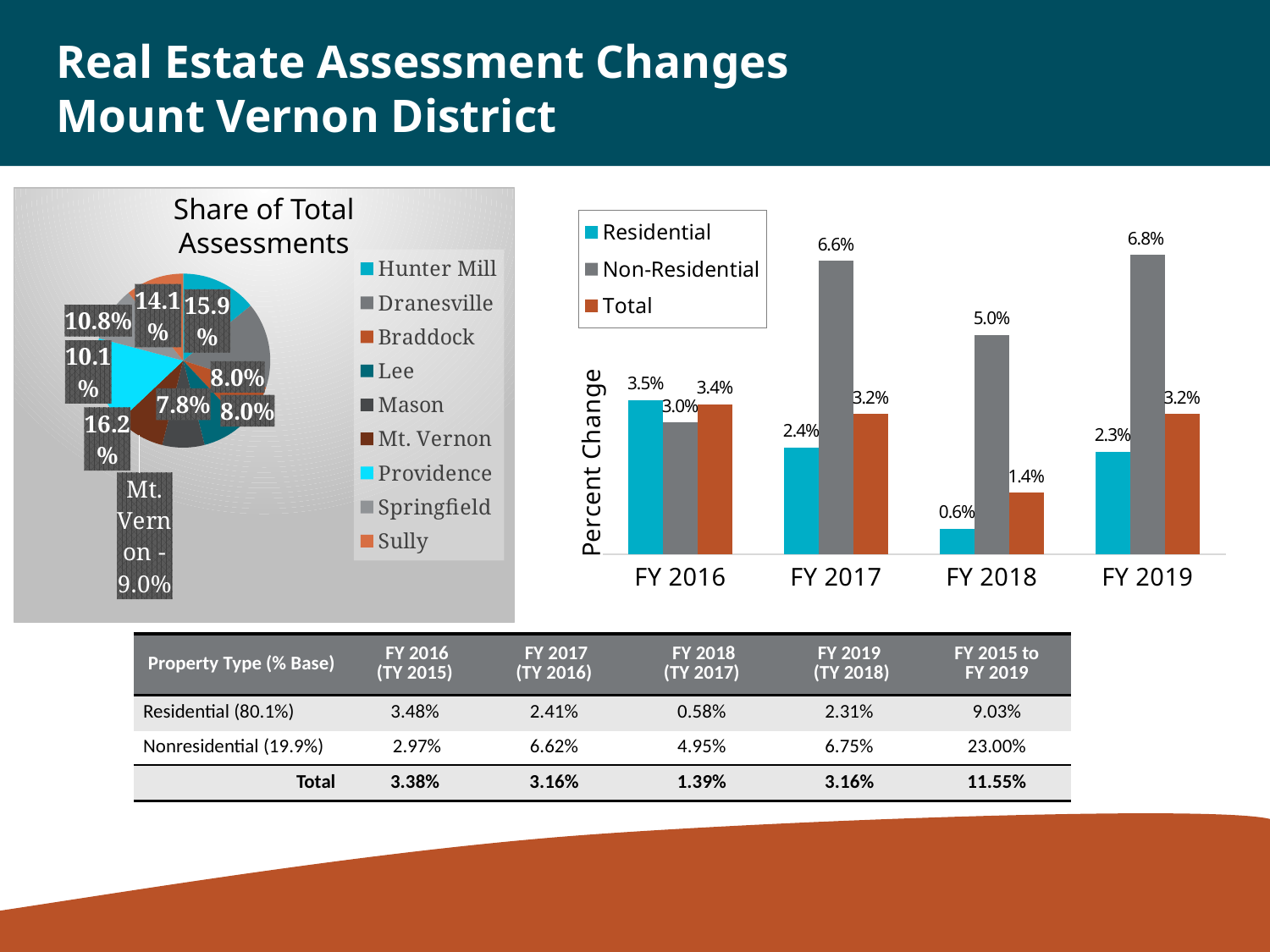
In the bar chart on the right, what is the Total value for FY 2016? 3.4% In the bar chart on the right, what is the Non-Residential value for FY 2017? 6.6% In the bar chart on the right, which is larger for FY 2016: Residential or Non-Residential? Residential In the bar chart on the right, what is the Residential value for FY 2018? 0.6% In the bar chart on the right, how many series does the legend list? 3 In the bar chart on the right, does the Residential value rise or fall from FY 2016 to FY 2018? fall In the 'Share of Total Assessments' pie chart, what share does Mt. Vernon have? 9.0% In the 'Share of Total Assessments' pie chart, how many districts does the legend list? 9 In the bar chart on the right, how many fiscal years are shown on the x axis? 4 In the bar chart on the right, which fiscal year has the lowest Residential value? FY 2018 In the bar chart on the right, which fiscal year has the highest Non-Residential value? FY 2019 In the bar chart on the right, what is the difference between the Non-Residential and Residential values for FY 2019? 4.5%